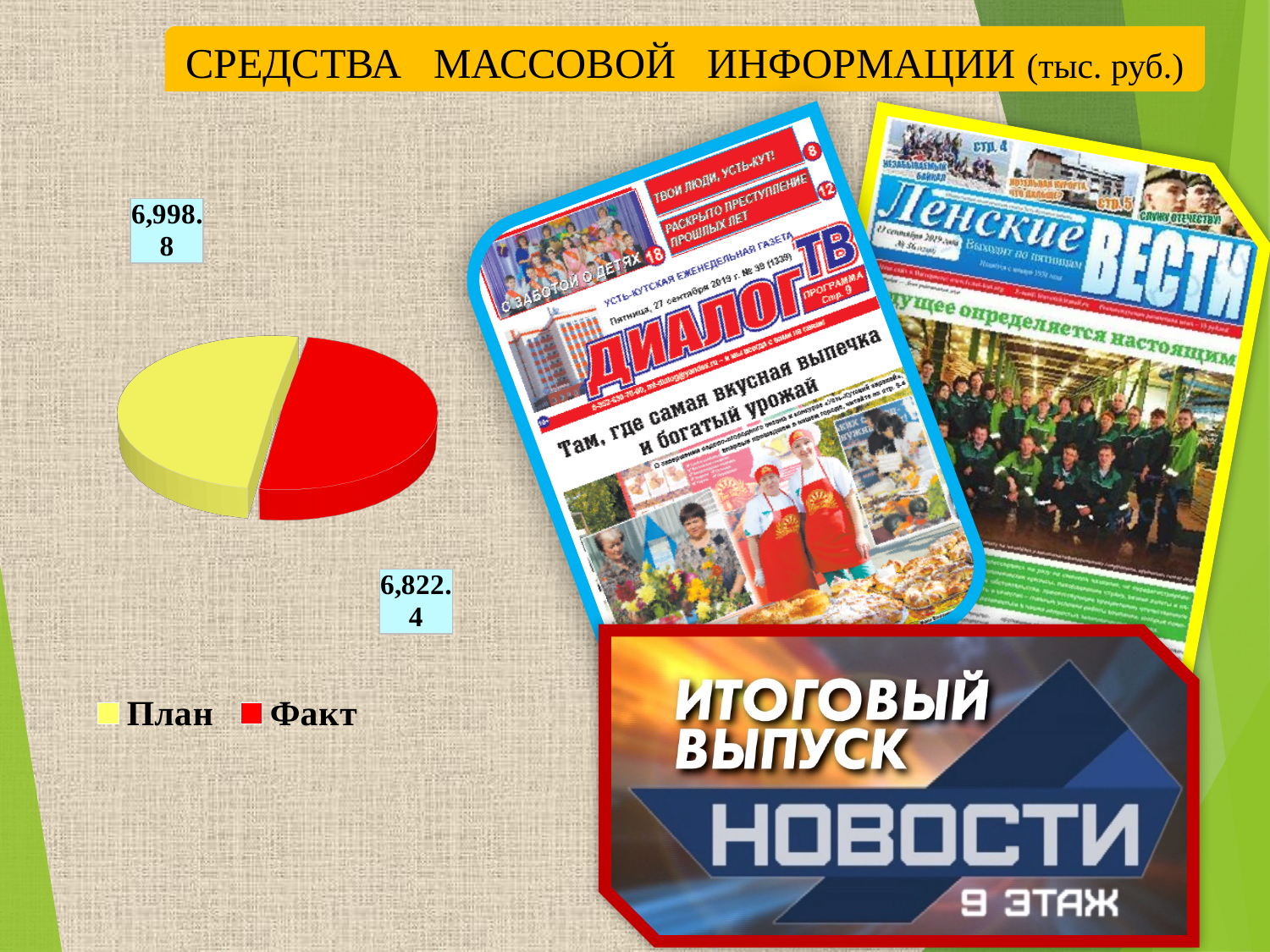
How many slices does the pie chart have? 2 What is the value for Факт in the pie chart? 6,822.4 What unit is given in the slide title for the chart values? тыс. руб. What colour represents Факт in the pie chart? red Which slice of the pie chart has the highest value? План Which category has the larger value, План or Факт? План How many entries does the legend list? 2 What is the value for План in the pie chart? 6,998.8 What is the total of the two values shown in the pie chart? 13,821.2 Which slice of the pie chart has the lowest value? Факт What is the difference between the План and Факт values? 176.4 What type of chart is shown on the slide? pie chart